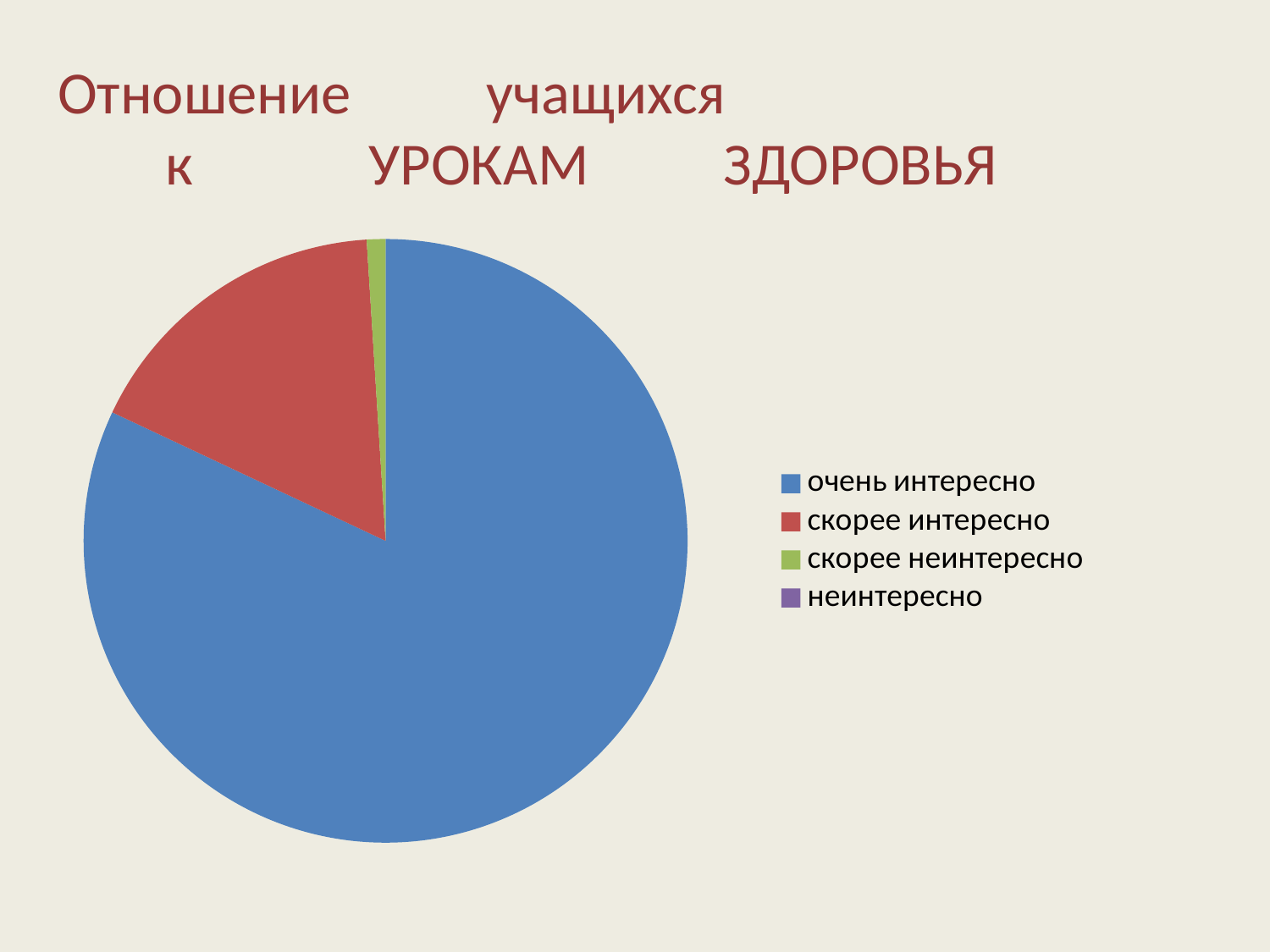
What colour is the slice for "очень интересно"? blue Which is larger, the slice for "скорее интересно" or the slice for "скорее неинтересно"? скорее интересно What kind of chart is shown on the slide? pie chart How many categories does the legend list? 4 Does the slice for "очень интересно" take up more or less than half of the pie? more Which category has the largest slice of the pie? очень интересно Which is larger, the slice for "очень интересно" or the slice for "скорее интересно"? очень интересно What colour is the slice for "скорее интересно"? red